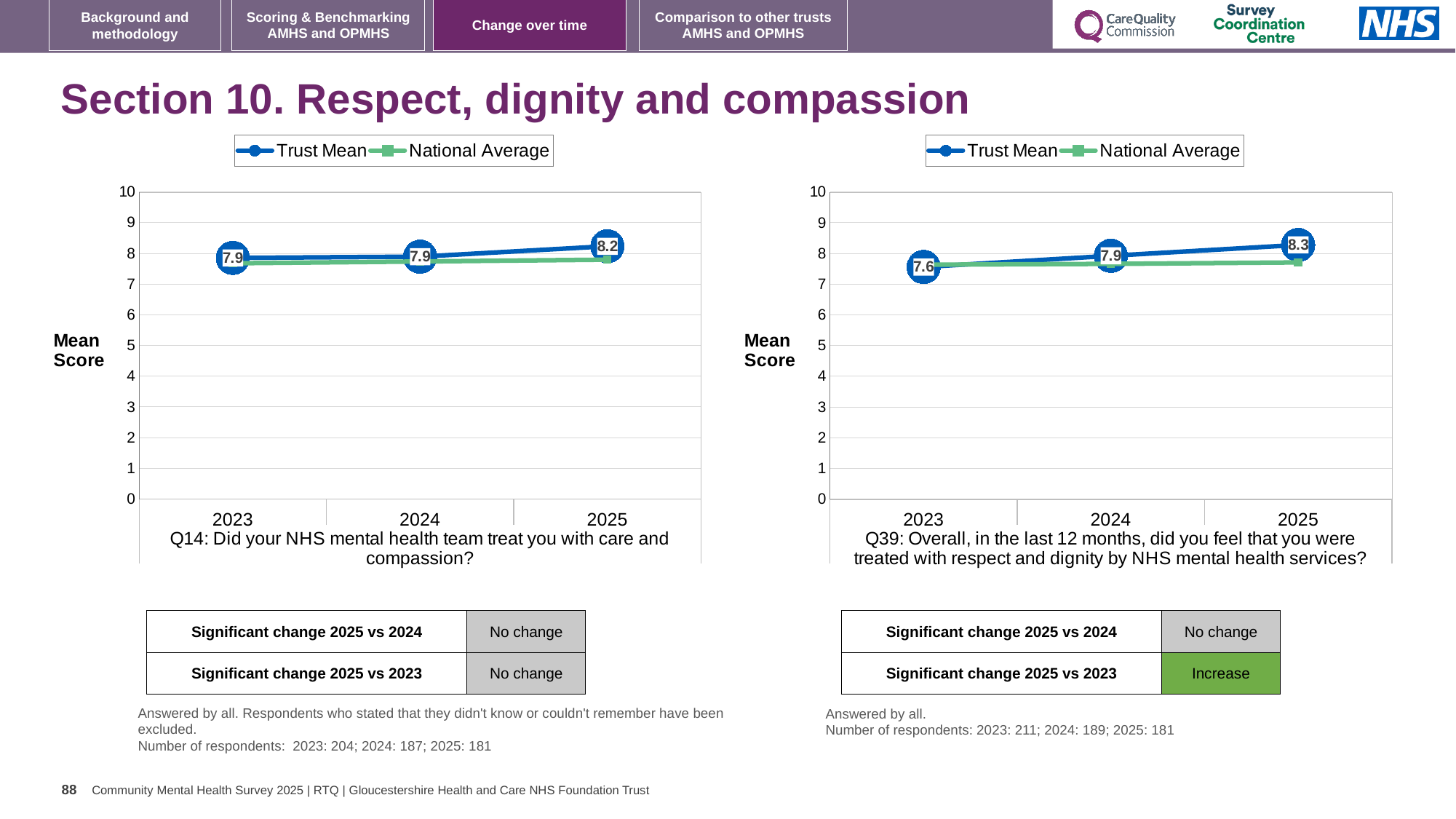
On the Q39 chart (right), what is the Trust Mean for 2025? 8.3 On the Q39 chart (right), which year has the highest Trust Mean? 2025 On the Q39 chart (right), which year has the lowest Trust Mean? 2023 On the Q39 chart (right), does the Trust Mean rise or fall from 2023 to 2025? rise On the Q39 chart (right), what is the Trust Mean for 2023? 7.6 On the Q39 chart (right), what is the difference between the Trust Mean in 2025 and in 2023? 0.7 On the Q14 chart (left), what is the Trust Mean for 2023? 7.9 What kind of chart is the Q39 chart (right)? line chart On the Q14 chart (left), what is the difference between the Trust Mean in 2025 and in 2024? 0.3 How many series does the legend of the Q14 chart (left) list? 2 On the Q14 chart (left), is the Trust Mean for 2025 greater or less than 8? greater On the Q14 chart (left), what is the Trust Mean for 2025? 8.2